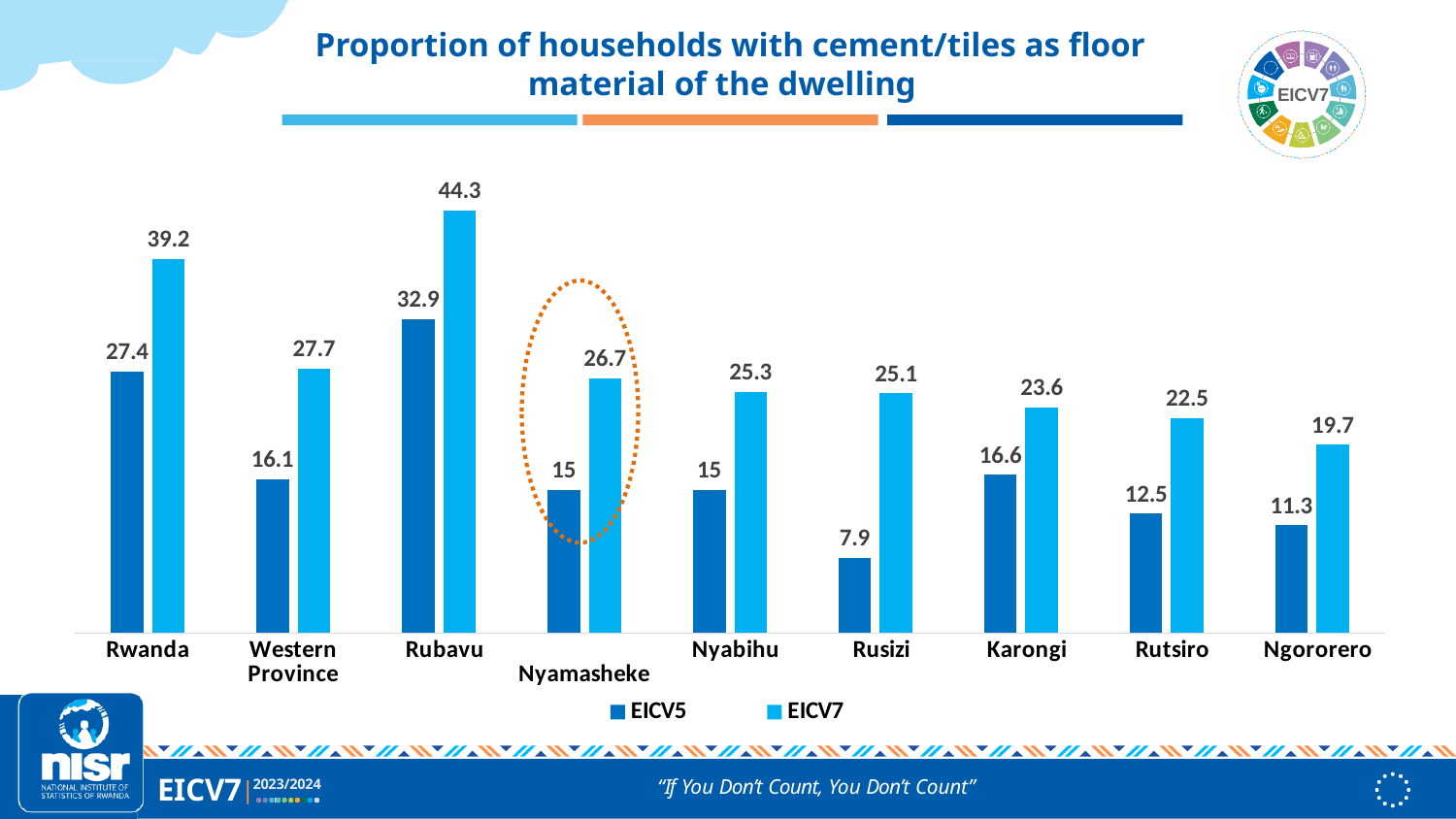
Which category has the lowest EICV5 value? Rusizi What is the difference between the EICV7 and EICV5 values for Nyamasheke? 11.7 Which category is highlighted with a dotted orange circle? Nyamasheke What is the EICV5 value for Nyamasheke? 15 Which is larger, the EICV7 value for Karongi or the EICV7 value for Rutsiro? Karongi What is the EICV5 value for Ngororero? 11.3 How many series does the legend list? 2 What kind of chart is shown on the slide? Bar chart What is the EICV7 value for Rubavu? 44.3 How many categories are shown on the x axis? 9 What is the EICV7 value for Rwanda? 39.2 Which category has the highest EICV7 value? Rubavu